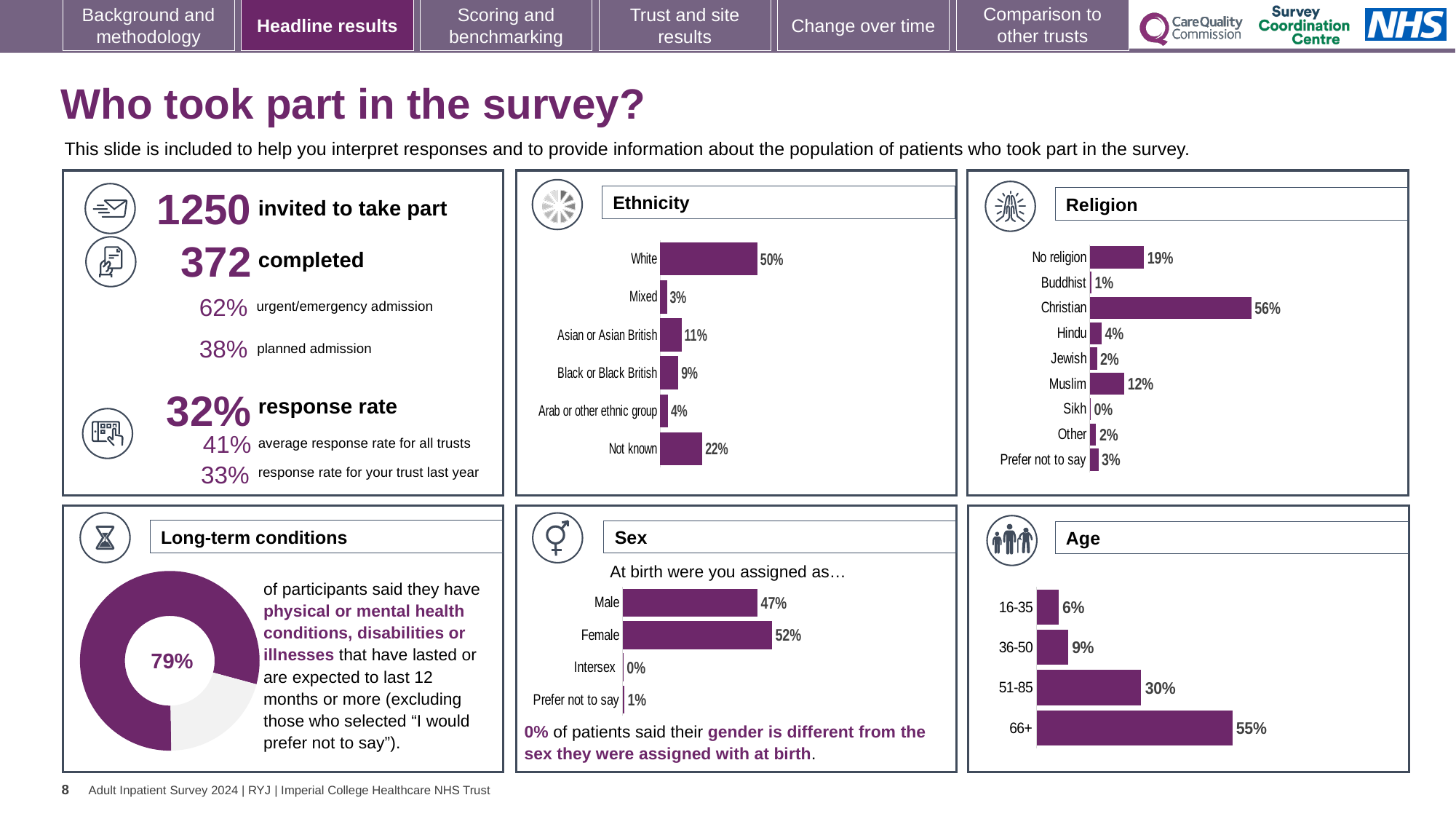
In the Ethnicity chart, what is the value for White? 50% In the Religion chart, how many categories are shown? 9 In the Ethnicity chart, which category has the lowest value? Mixed In the Age chart, do the values rise or fall from 16-35 to 66+? rise In the Age chart, what is the value for 66+? 55% In the Religion chart, what is the difference between Christian and No religion? 37% In the Religion chart, what is the value for Muslim? 12% What kind of chart is the Long-term conditions chart? doughnut chart In the Sex chart, what is the value for Prefer not to say? 1% In the Religion chart, which category has the highest value? Christian In the Sex chart, which is larger, Male or Female? Female In the Ethnicity chart, how many categories are shown? 6